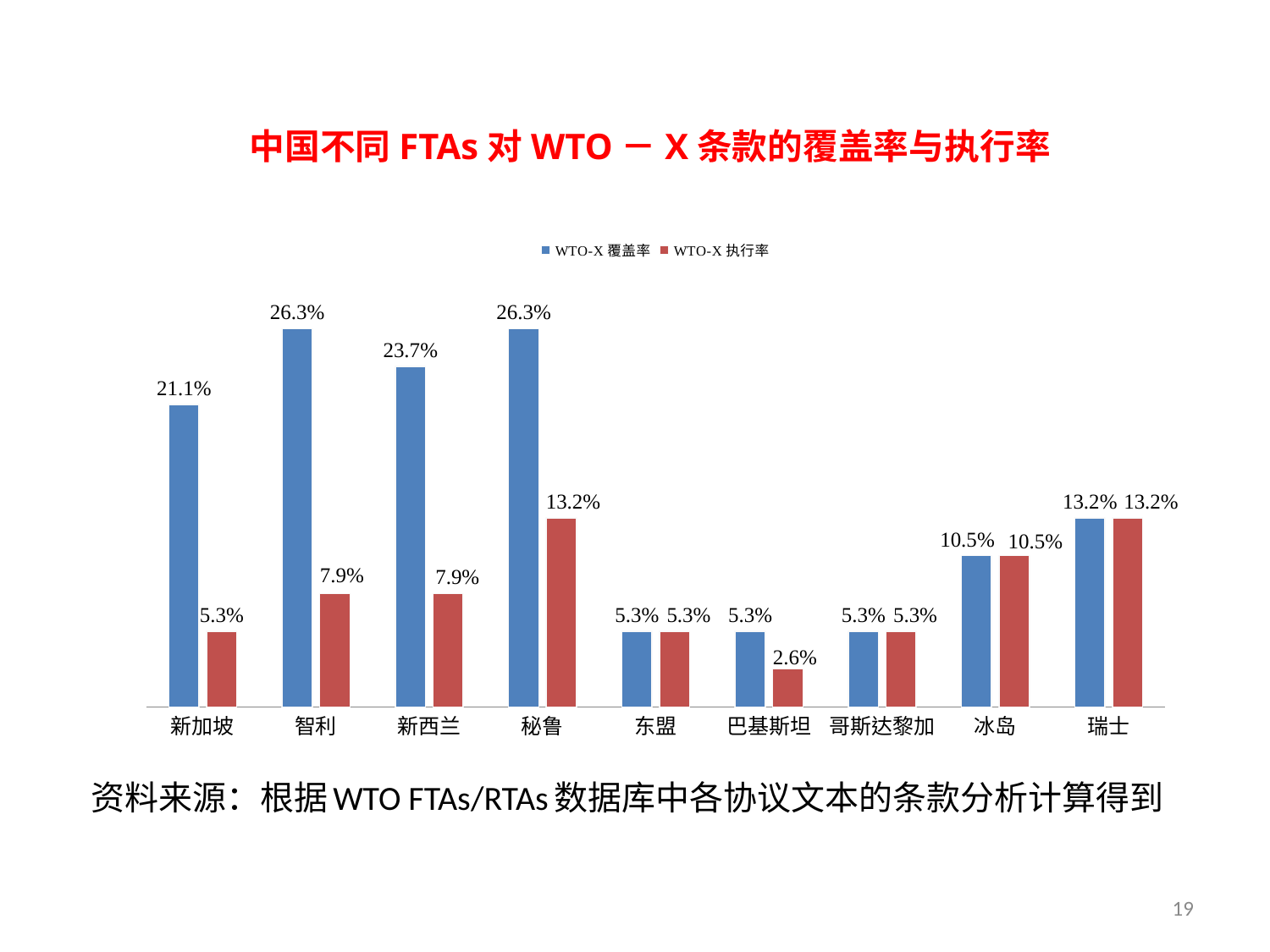
What is the WTO-X 执行率 value for 巴基斯坦? 2.6% What colour are the WTO-X 执行率 bars? red Which category has the highest WTO-X 执行率 value? 秘鲁 and 瑞士 (tied at 13.2%) How many series does the legend list? 2 Which category has the lowest WTO-X 执行率 value? 巴基斯坦 How many categories are shown on the x axis? 9 What is the WTO-X 覆盖率 value for 新加坡? 21.1% What is the difference between the WTO-X 覆盖率 values for 秘鲁 and 东盟? 21.0% What is the difference between the WTO-X 覆盖率 and WTO-X 执行率 values for 智利? 18.4% What kind of chart is shown on the slide? bar chart What is the WTO-X 执行率 value for 秘鲁? 13.2% Which is larger for 新西兰: the WTO-X 覆盖率 value or the WTO-X 执行率 value? WTO-X 覆盖率